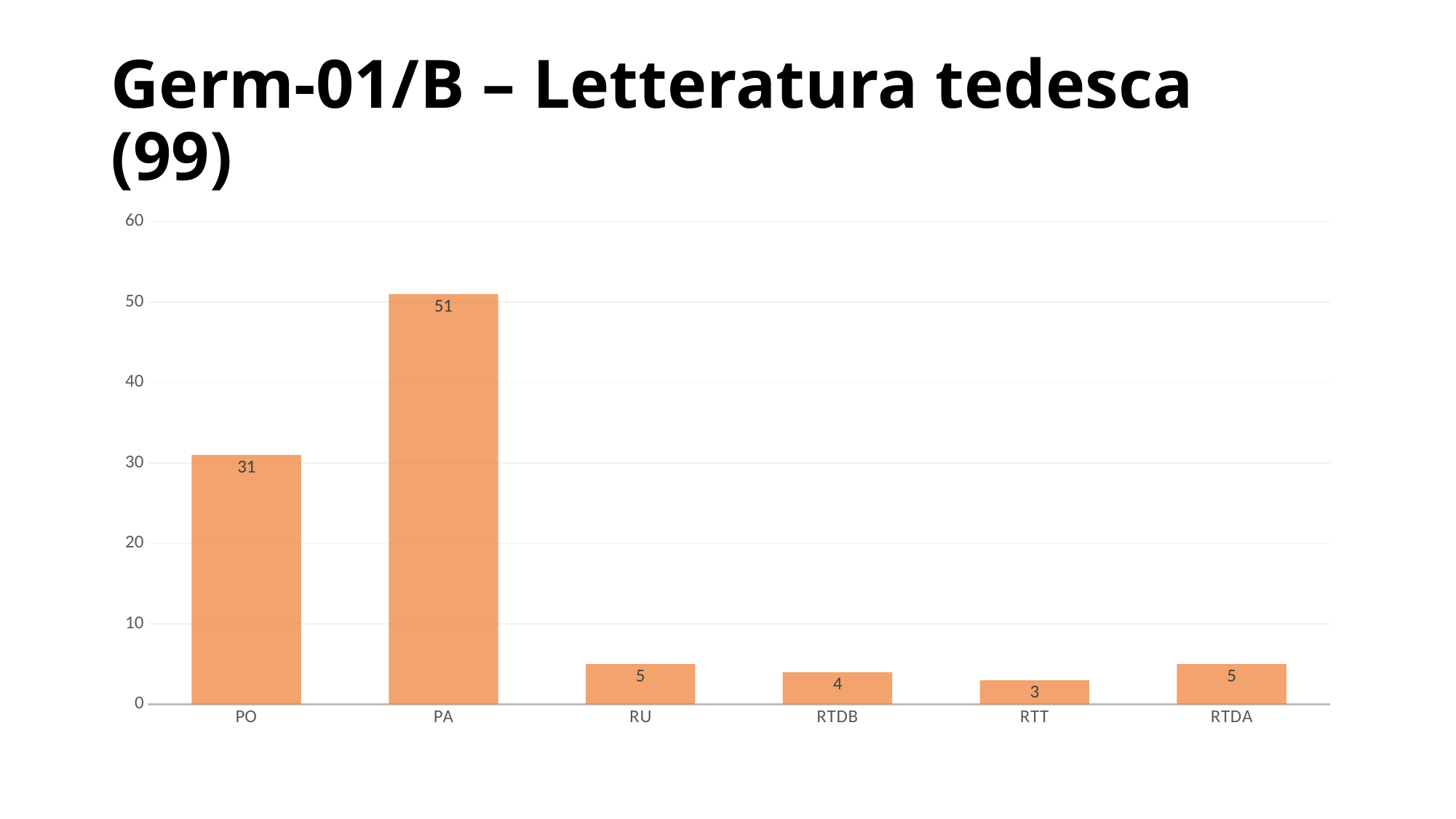
What is the title of the slide? Germ-01/B – Letteratura tedesca (99) What is the value for RTT? 3 Is the value for PA greater or less than 40? greater Which category has the highest value? PA What kind of chart is shown on the slide? bar chart What is the difference between the values for PA and PO? 20 How many categories are shown on the x axis? 6 What is the value for RTDB? 4 Which is larger, the value for RU or the value for RTDB? RU Which category has the lowest value? RTT What is the value for PA? 51 What is the value for PO? 31